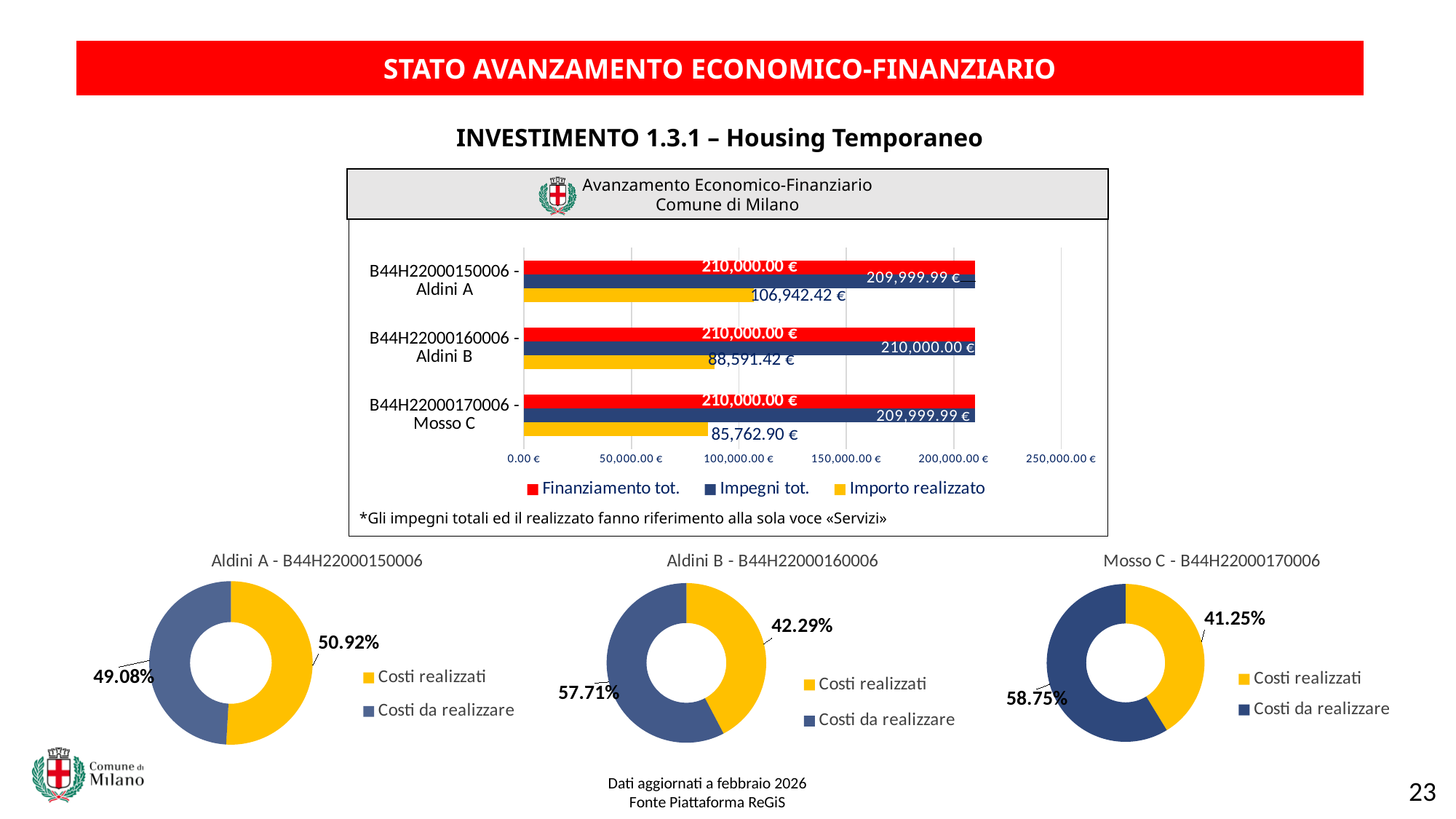
In the bar chart 'Avanzamento Economico-Finanziario Comune di Milano', which category has the highest Importo realizzato? B44H22000150006 - Aldini A In the donut chart 'Mosso C - B44H22000170006', what share is Costi da realizzare? 58.75% What kind of chart is the 'Avanzamento Economico-Finanziario Comune di Milano' chart? Bar chart In the bar chart 'Avanzamento Economico-Finanziario Comune di Milano', what is the Impegni tot. value for B44H22000160006 - Aldini B? 210,000.00 € In the bar chart 'Avanzamento Economico-Finanziario Comune di Milano', what is the Importo realizzato for B44H22000150006 - Aldini A? 106,942.42 € How many series does the legend of the bar chart 'Avanzamento Economico-Finanziario Comune di Milano' list? 3 In the bar chart 'Avanzamento Economico-Finanziario Comune di Milano', what is the difference between the Importo realizzato of Aldini A and that of Aldini B? 18,351.00 € In the bar chart 'Avanzamento Economico-Finanziario Comune di Milano', which category has the lowest Importo realizzato? B44H22000170006 - Mosso C In the donut chart 'Aldini B - B44H22000160006', which slice is larger, Costi realizzati or Costi da realizzare? Costi da realizzare In the bar chart 'Avanzamento Economico-Finanziario Comune di Milano', is the Importo realizzato for Aldini B greater or less than 100,000.00 €? less In the donut chart 'Aldini A - B44H22000150006', what share is Costi realizzati? 50.92% In the bar chart 'Avanzamento Economico-Finanziario Comune di Milano', what is the Importo realizzato for B44H22000170006 - Mosso C? 85,762.90 €